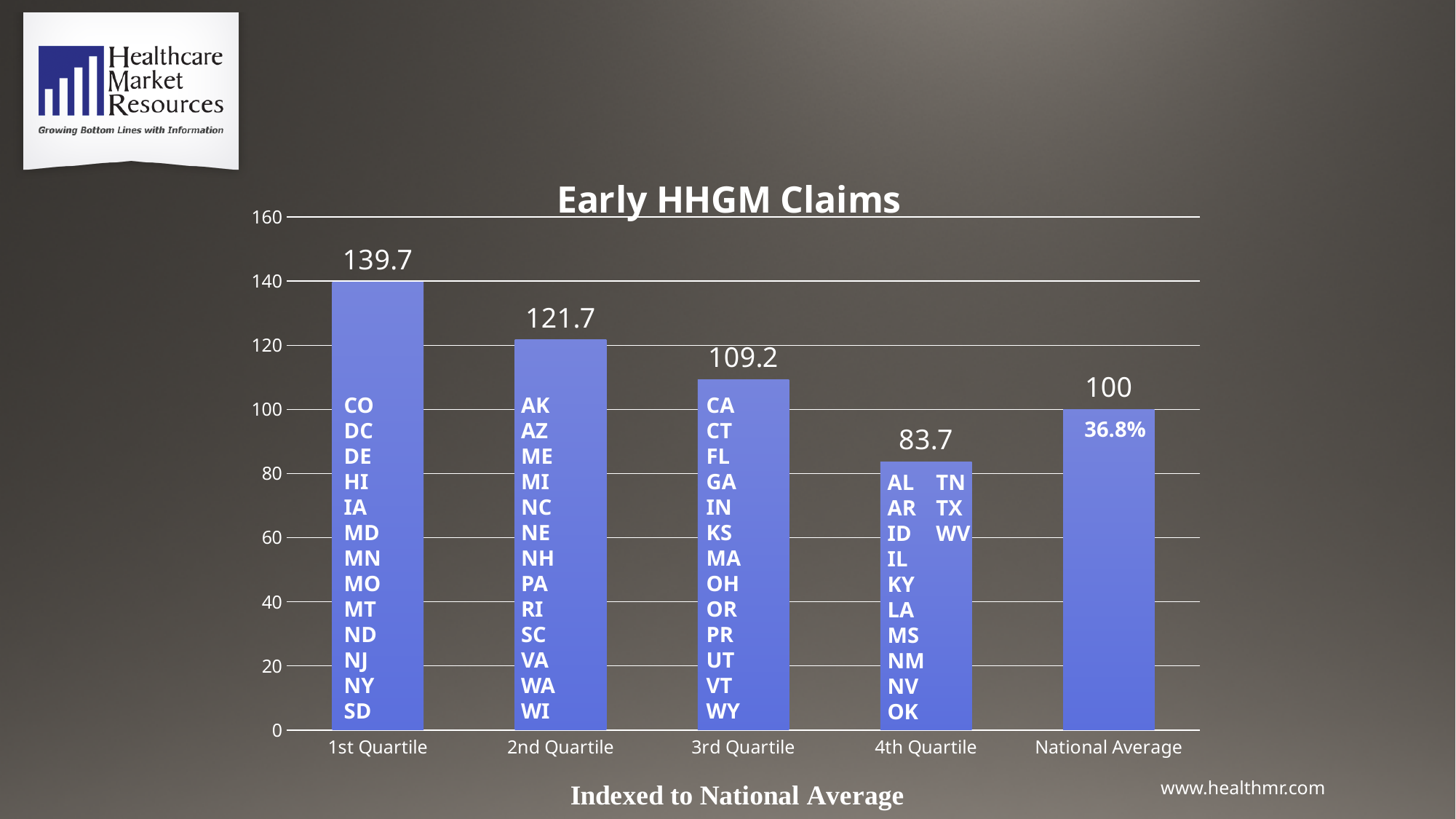
How many bars are shown in the chart? 5 Is the value for 4th Quartile greater or less than 100? less Which category has the highest value? 1st Quartile What is the difference between the National Average and the 4th Quartile value? 16.3 What is the title of the chart? Early HHGM Claims What is the difference between the 1st Quartile and 2nd Quartile values? 18 What is the value for 3rd Quartile? 109.2 Which category has the lowest value? 4th Quartile What kind of chart is shown on the slide? bar chart Which is larger, the value for 2nd Quartile or 3rd Quartile? 2nd Quartile What is the value for 1st Quartile? 139.7 What is the value for National Average? 100